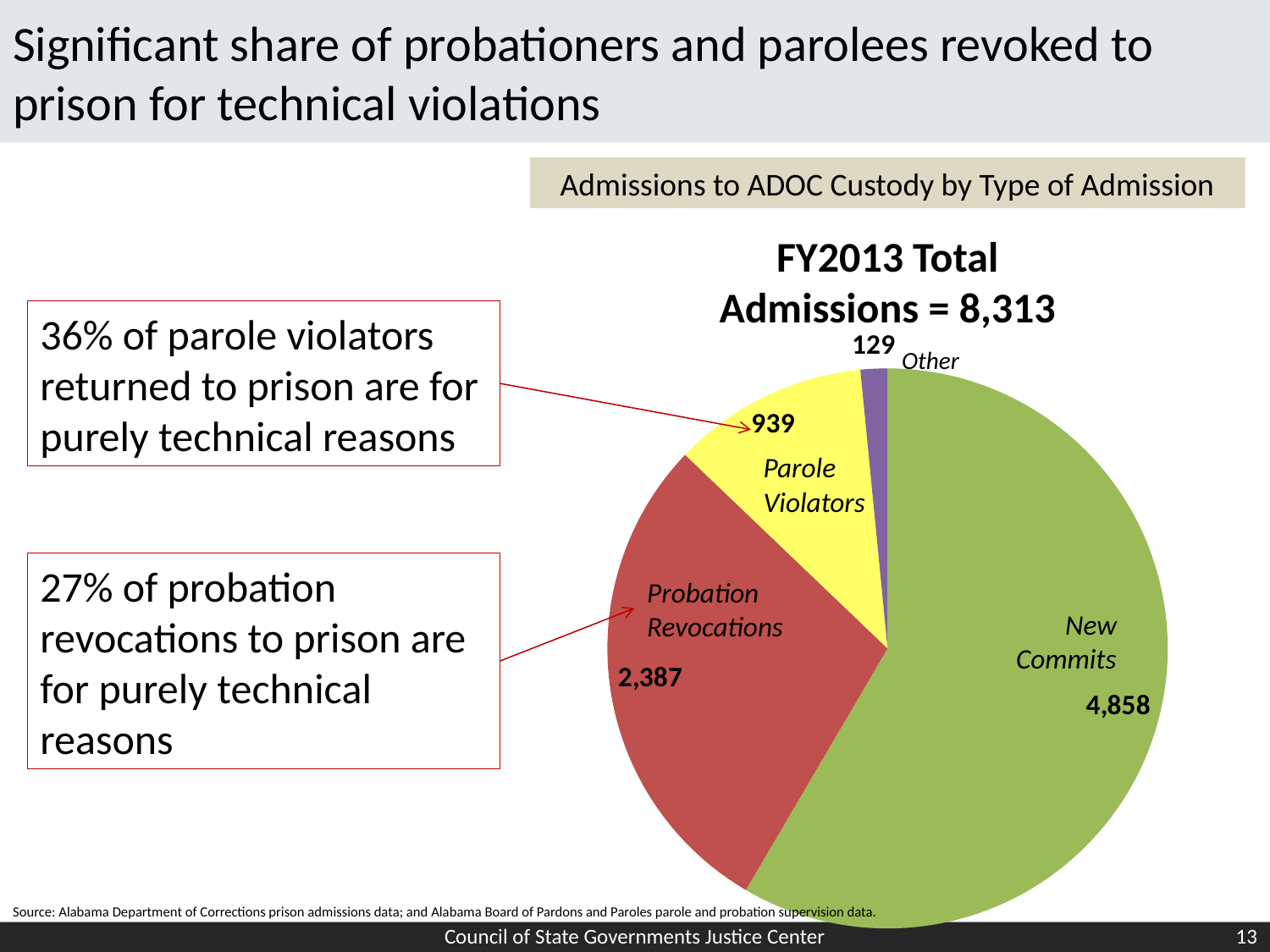
How many admissions were Probation Revocations? 2,387 Which type of admission has the smallest slice of the pie? Other How many admissions fall in the Other category? 129 What is the difference between New Commits and Probation Revocations admissions? 2,471 What is the difference between Probation Revocations and Parole Violators admissions? 1,448 What type of chart is shown on the slide? Pie chart Which type of admission has the largest slice of the pie? New Commits How many admission categories are shown in the pie chart? 4 How many admissions were New Commits in FY2013? 4,858 Which is larger, Parole Violators or Probation Revocations? Probation Revocations How many admissions were Parole Violators? 939 What is the total number of FY2013 admissions shown on the chart? 8,313